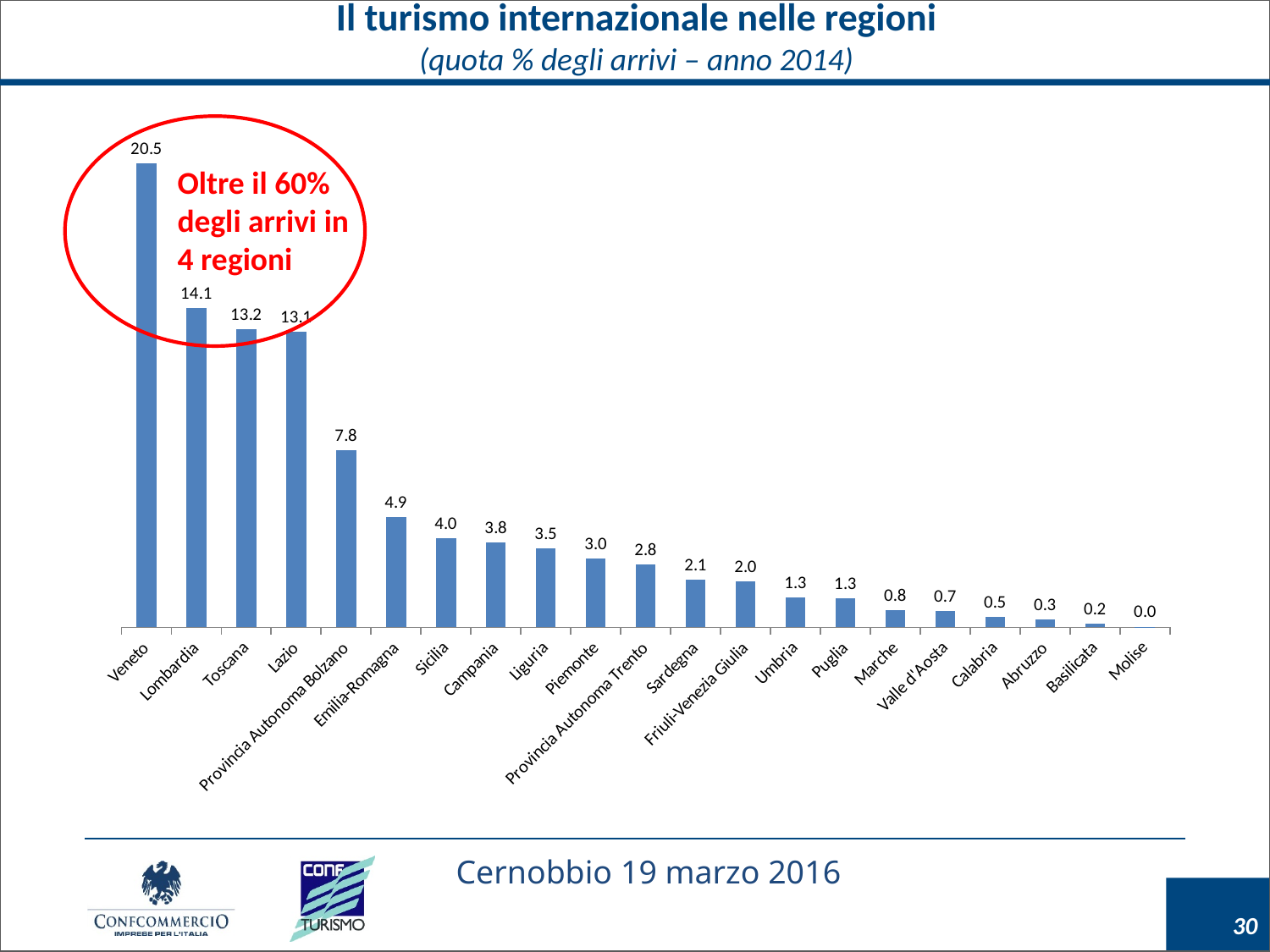
Which region has the highest value? Veneto What is the value for Sardegna? 2.1 What is the difference between the values for Veneto and Lombardia? 6.4 Do the values rise or fall from left to right along the x axis? Fall What is the title of the chart? Il turismo internazionale nelle regioni What is the difference between the values for Emilia-Romagna and Sicilia? 0.9 How many regions are shown on the x axis? 21 Which has a larger value, Campania or Piemonte? Campania What kind of chart is shown on the slide? Bar chart What is the value for Veneto? 20.5 Which region has the lowest value? Molise What is the value for Provincia Autonoma Bolzano? 7.8